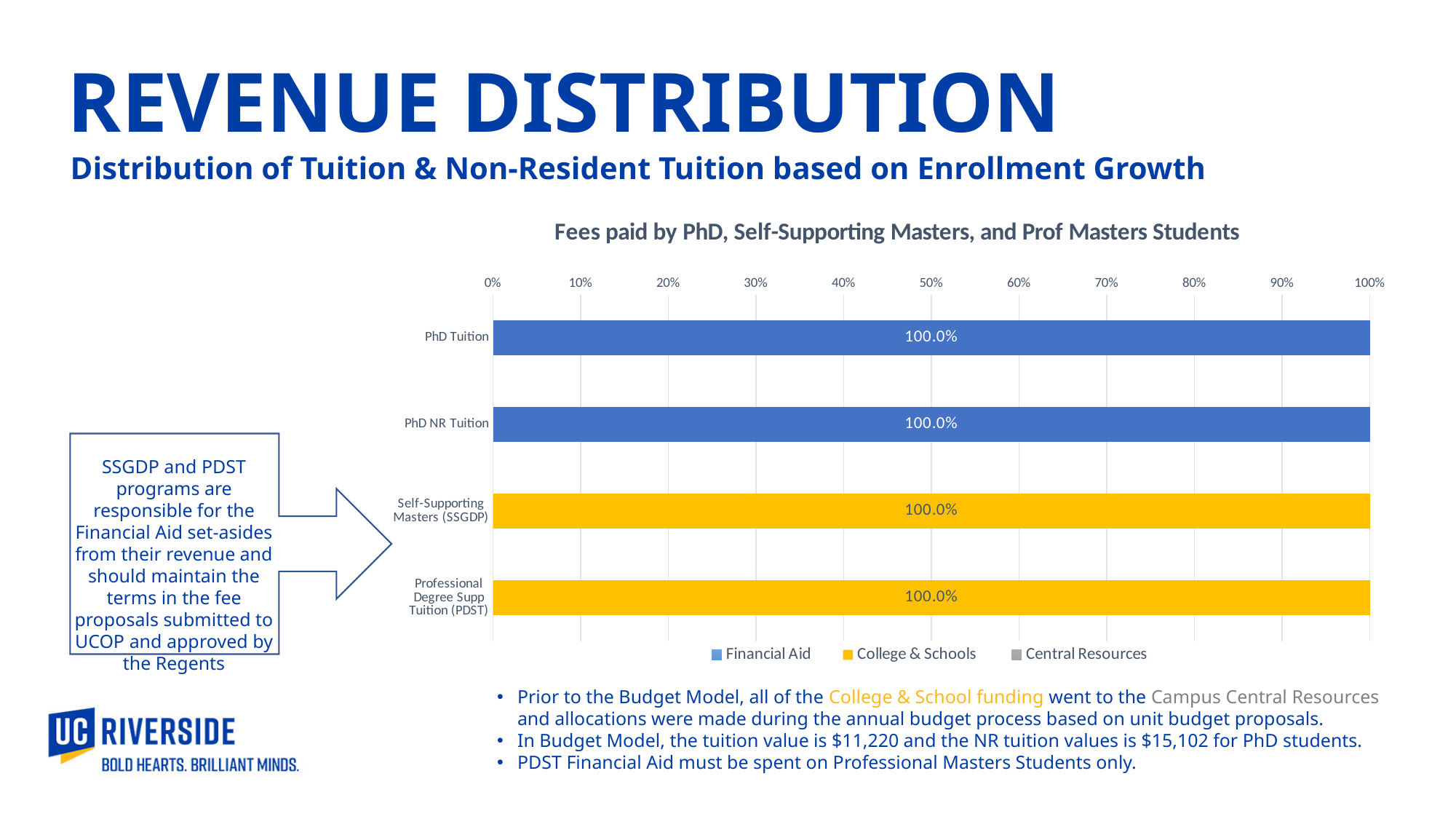
What is the difference between the PhD Tuition value and the PDST value? 0.0% What is the total of the stacked bar for PhD NR Tuition? 100.0% Is the value for Self-Supporting Masters (SSGDP) greater or less than 50%? greater How many categories are plotted on the chart? 4 What value is labelled on the Professional Degree Supp Tuition (PDST) bar? 100.0% What value is labelled on the PhD NR Tuition bar? 100.0% What is the title of the chart? Fees paid by PhD, Self-Supporting Masters, and Prof Masters Students What is the College & Schools share shown for Self-Supporting Masters (SSGDP)? 100.0% What is the Financial Aid share shown for PhD Tuition? 100.0% How many series does the legend list? 3 Which series does the PhD Tuition bar belong to, according to the legend colour? Financial Aid What kind of chart is shown on the slide? Bar chart